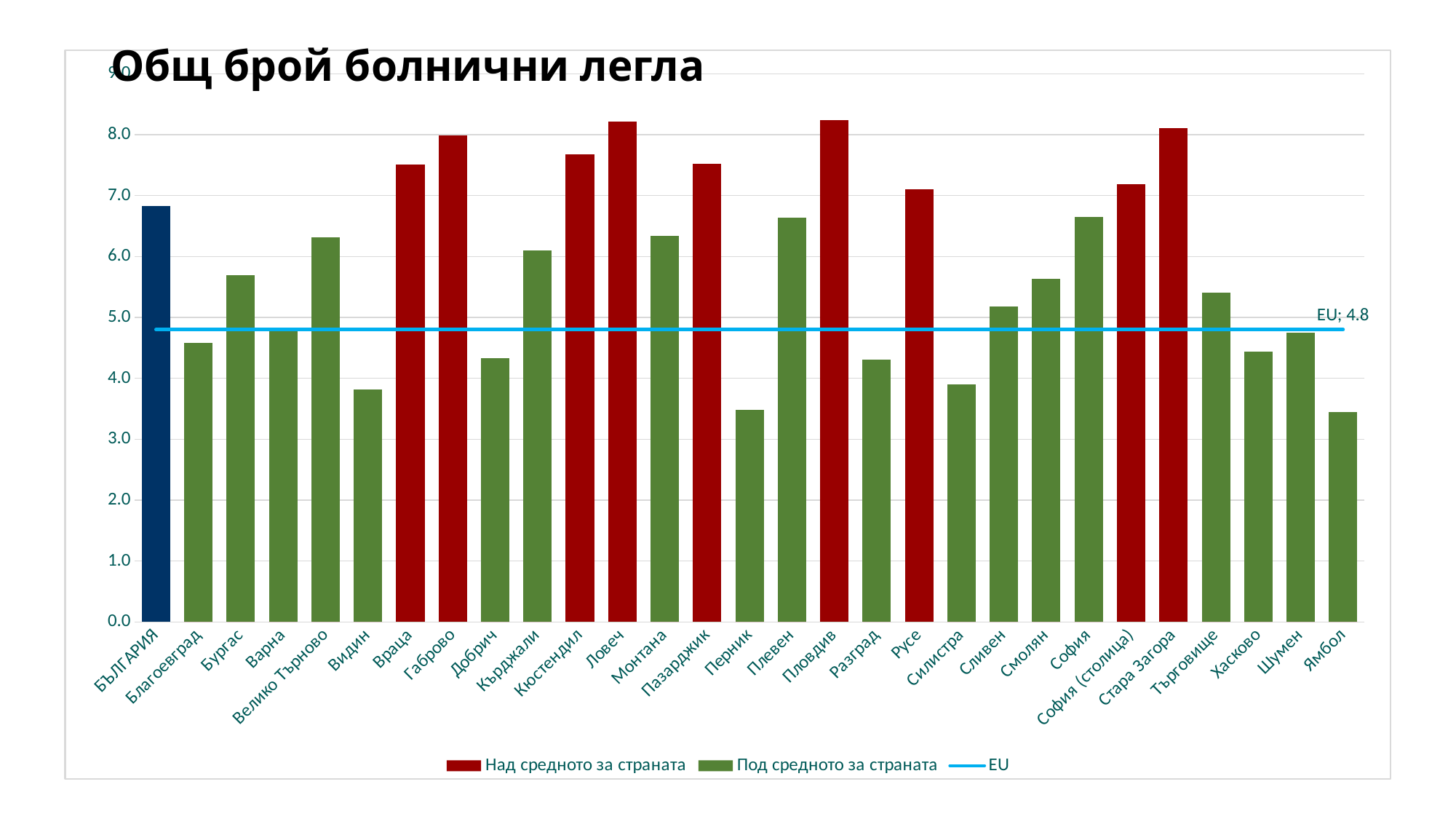
Is the value for Перник greater or less than 4.0? less What kind of chart is shown on the slide? bar chart Is the value for Плевен greater or less than 6.0? greater Which has the larger value, Бургас or Варна? Бургас What value is labelled on the EU line? 4.8 What colour are the bars for the series 'Над средното за страната'? red Is the value for Благоевград greater or less than 5.0? less Which has the larger value, Враца or Видин? Враца How many entries does the legend list? 3 What is the title of the chart? Общ брой болнични легла How many categories are shown on the x axis? 29